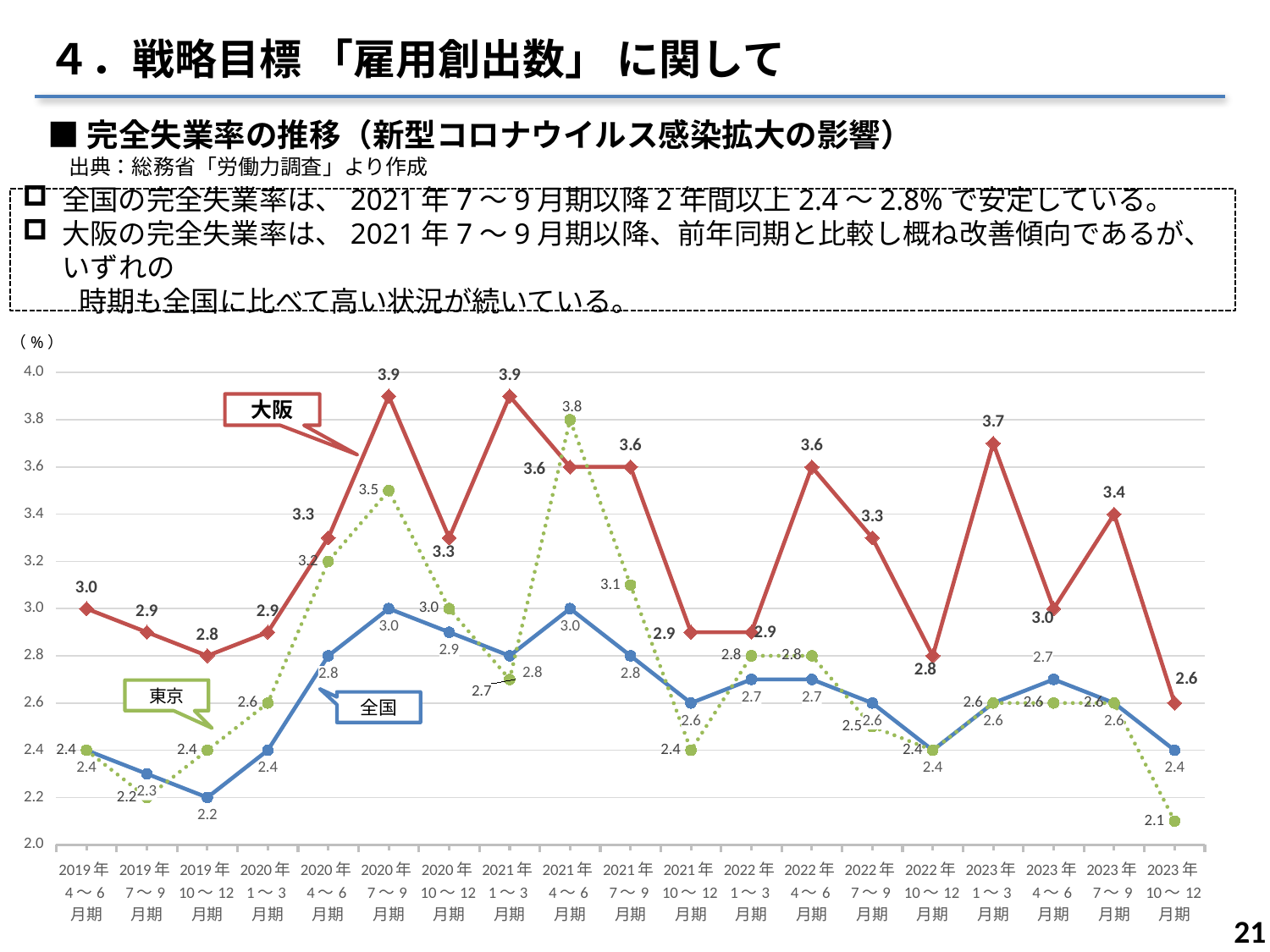
How many series are plotted in the chart? 3 In which period does 東京 reach its lowest value? 2023年10〜12月期 In which period does 東京 reach its highest value? 2021年4〜6月期 How many quarterly periods are shown on the x axis of the chart? 19 What kind of chart is shown on the slide? Line chart In 2021年4〜6月期, which is higher, 東京 or 大阪? 東京 What is the value for 大阪 in 2023年10〜12月期? 2.6 What unit is shown at the top of the y axis? % What is the difference between 大阪 and 全国 in 2023年10〜12月期? 0.2 What is the value for 全国 in 2020年7〜9月期? 3.0 What is the value for 東京 in 2021年4〜6月期? 3.8 Does the value for 大阪 rise or fall from 2023年7〜9月期 to 2023年10〜12月期? Fall